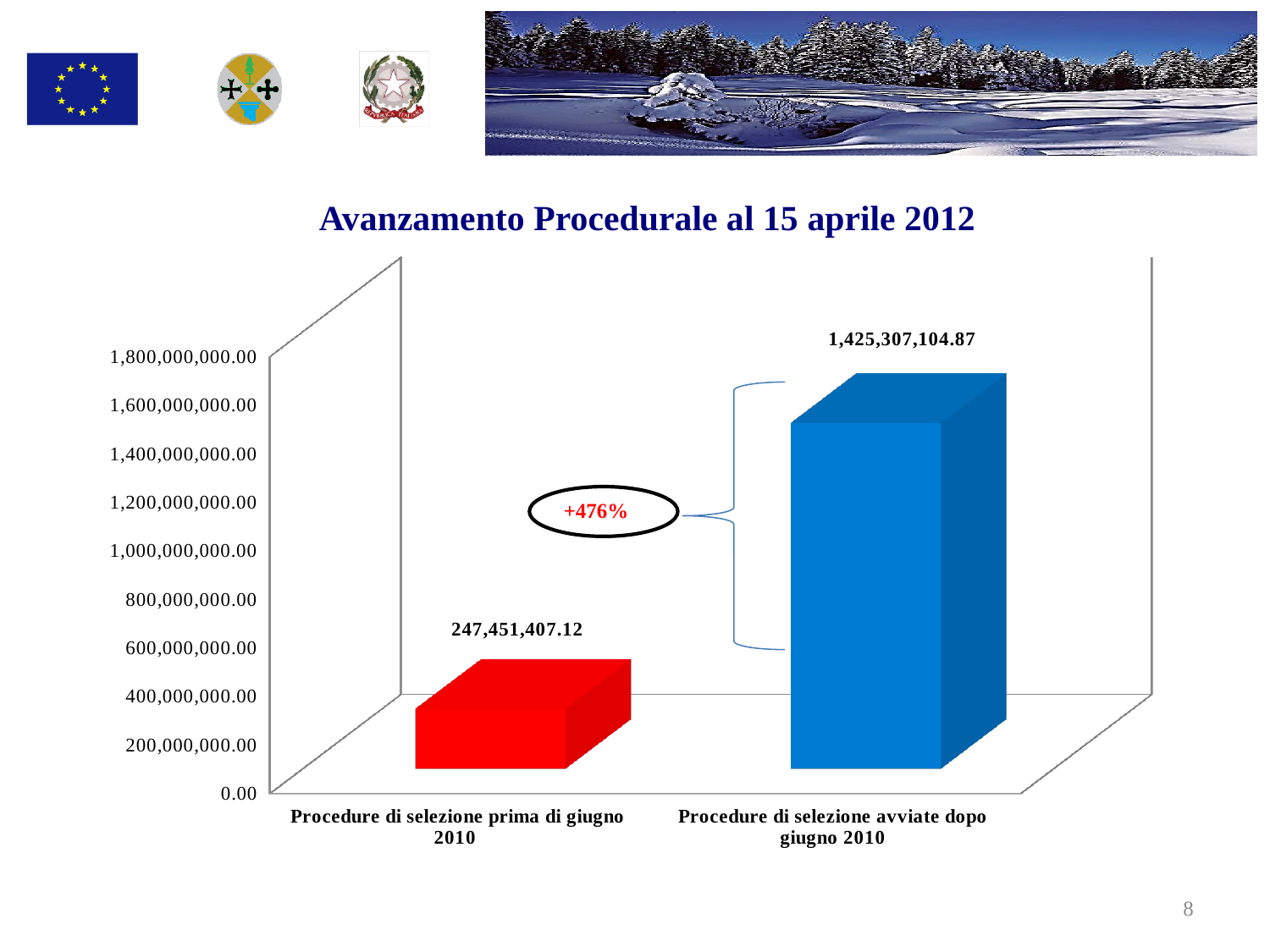
Which is larger: the value for "Procedure di selezione prima di giugno 2010" or the value for "Procedure di selezione avviate dopo giugno 2010"? Procedure di selezione avviate dopo giugno 2010 Is the value for "Procedure di selezione prima di giugno 2010" greater or less than 400,000,000.00? less Which category has the lowest value? Procedure di selezione prima di giugno 2010 What is the title of the chart? Avanzamento Procedurale al 15 aprile 2012 What is the difference between the value for "Procedure di selezione avviate dopo giugno 2010" and the value for "Procedure di selezione prima di giugno 2010"? 1,177,855,697.75 What percentage change is shown in the circled annotation between the two bars? +476% Is the value for "Procedure di selezione avviate dopo giugno 2010" greater or less than 1,200,000,000.00? greater Which category has the highest value? Procedure di selezione avviate dopo giugno 2010 What is the value for "Procedure di selezione avviate dopo giugno 2010"? 1,425,307,104.87 What kind of chart is shown on the slide? bar chart How many categories are shown in the chart? 2 What is the value for "Procedure di selezione prima di giugno 2010"? 247,451,407.12